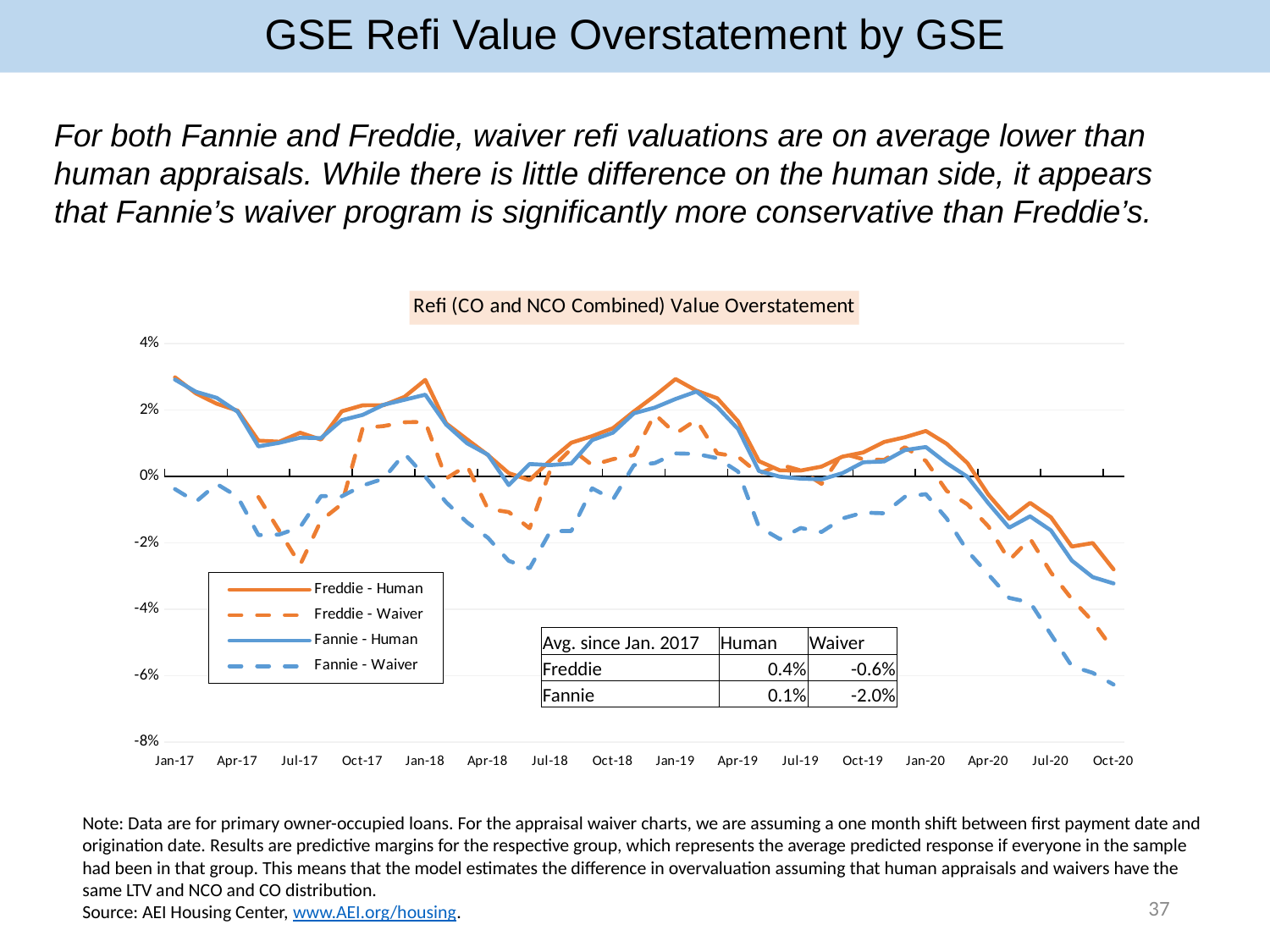
Is the value for Freddie - Human at Jan-17 greater or less than 2%? greater Does the Freddie - Human line rise or fall from Jan-20 to Oct-20? Fall How many date labels are shown on the x axis of the chart? 16 What is the title of the chart? Refi (CO and NCO Combined) Value Overstatement Is the value for Fannie - Waiver at Oct-20 greater or less than -4%? less What type of chart is shown on the slide? Line chart How many series does the chart legend list? 4 At Oct-20, which series has the higher value, Freddie - Human or Fannie - Waiver? Freddie - Human According to the table on the chart, what is the average Waiver value since Jan. 2017 for Fannie? -2.0% What are the four series named in the chart legend? Freddie - Human, Freddie - Waiver, Fannie - Human, Fannie - Waiver According to the table on the chart, what is the average Human value since Jan. 2017 for Freddie? 0.4%